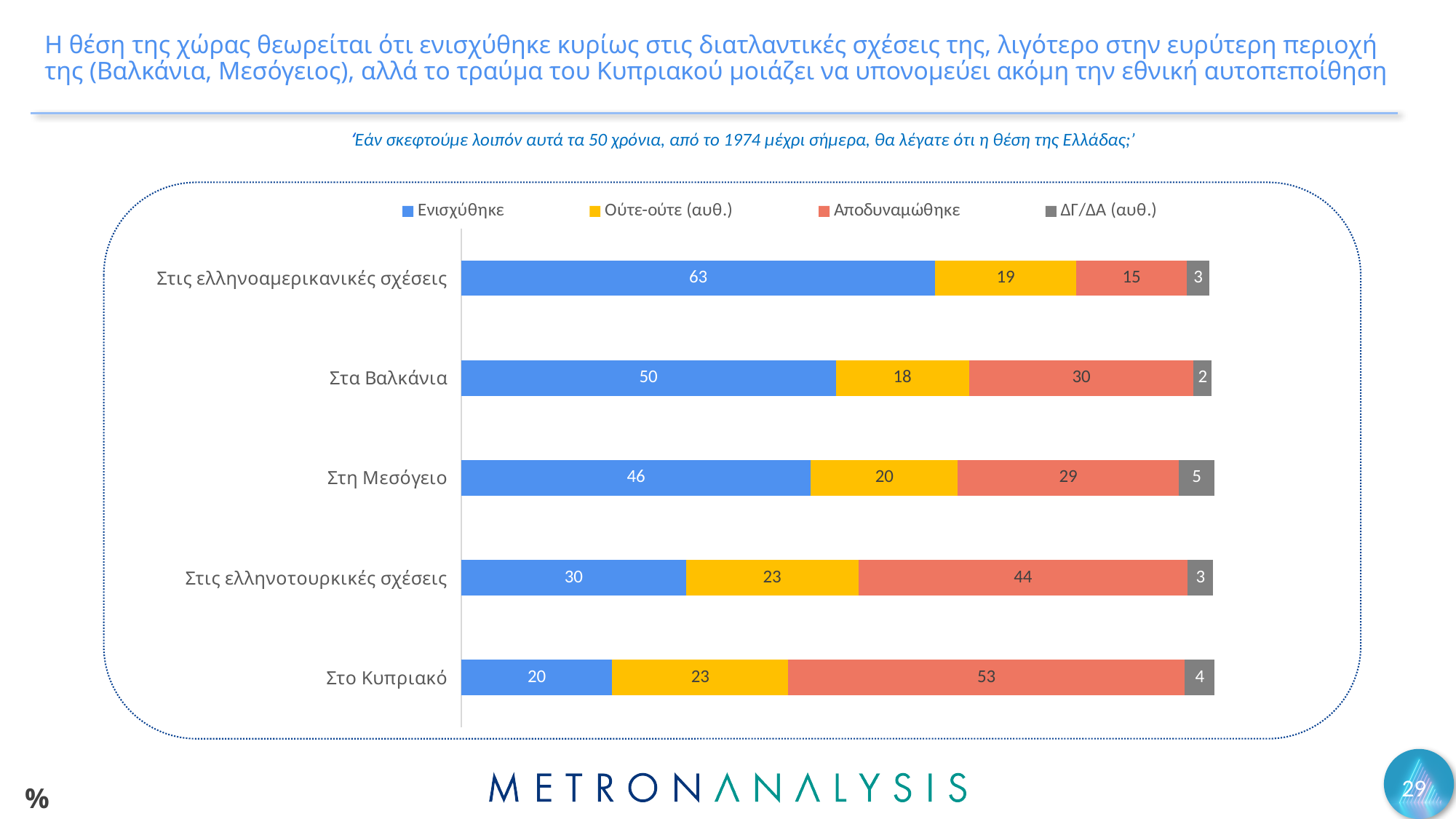
What type of chart is shown on the slide? Stacked bar chart What is the value of 'Ενισχύθηκε' for 'Στις ελληνοαμερικανικές σχέσεις'? 63 Which category has the highest value for 'Ενισχύθηκε'? Στις ελληνοαμερικανικές σχέσεις What is the value of 'Αποδυναμώθηκε' for 'Στο Κυπριακό'? 53 What is the total of the stacked bar for 'Στις ελληνοτουρκικές σχέσεις'? 100 What is the difference between the 'Αποδυναμώθηκε' values for 'Στο Κυπριακό' and 'Στις ελληνοτουρκικές σχέσεις'? 9 What is the value of 'Ούτε-ούτε (αυθ.)' for 'Στη Μεσόγειο'? 20 How many series does the legend list? 4 What is the value of 'ΔΓ/ΔΑ (αυθ.)' for 'Στα Βαλκάνια'? 2 How many categories are shown on the chart? 5 Which category has the lowest value for 'Αποδυναμώθηκε'? Στις ελληνοαμερικανικές σχέσεις Which is larger: the 'Ενισχύθηκε' value for 'Στα Βαλκάνια' or for 'Στη Μεσόγειο'? Στα Βαλκάνια